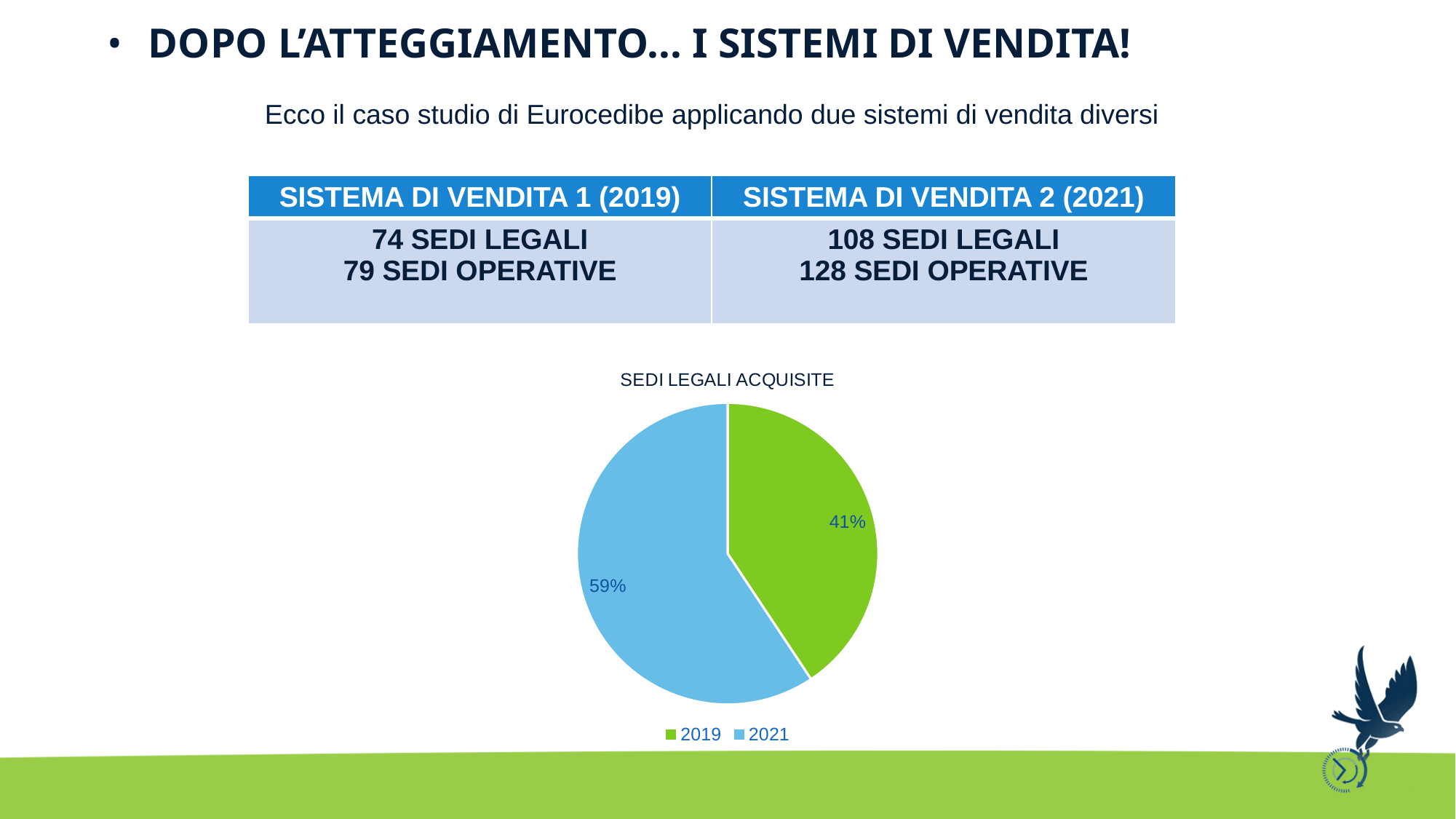
Which slice is the smallest in the pie chart? 2019 How many entries does the legend list? 2 What is the difference in percentage points between the 2021 slice and the 2019 slice? 18 percentage points Which is larger, the 2019 slice or the 2021 slice? 2021 What type of chart is shown on the slide? pie chart What share of the pie does 2021 represent? 59% Is the share for 2019 greater or less than 50%? less What share of the pie does 2019 represent? 41% How many slices does the pie chart have? 2 Which slice is the largest in the pie chart? 2021 What colour is the 2021 slice? light blue What is the title of the chart? SEDI LEGALI ACQUISITE